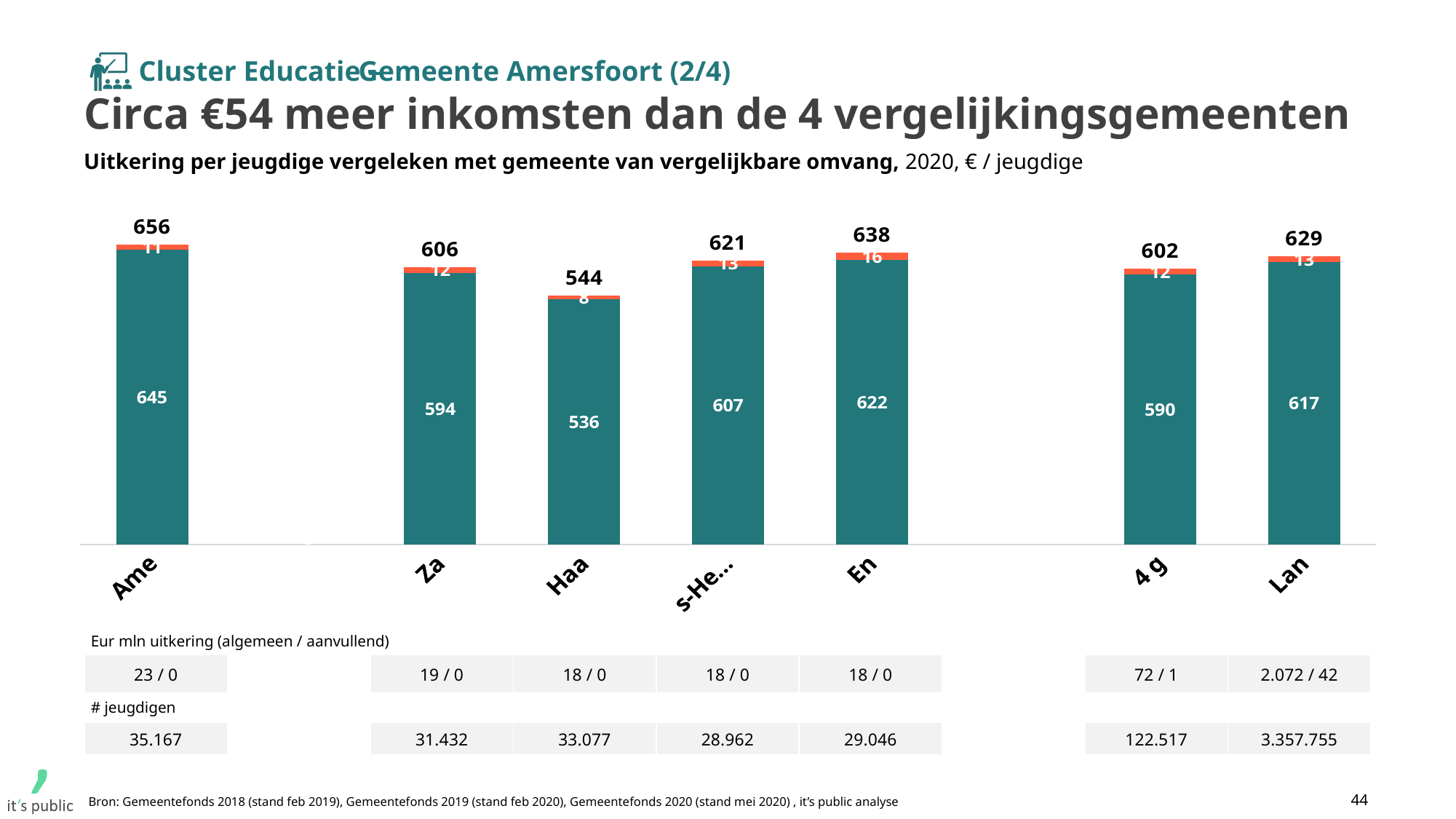
What is the difference between the total values for Ame and Haa? 112 What is the difference between the total values for Ame and 4 g? 54 What is the total value shown above the bar for Ame? 656 How many categories (bars) are shown in the chart? 7 What is the value of the large teal segment of the bar for En? 622 What is the value of the large teal segment of the bar for 4 g? 590 What kind of chart is shown on the slide? Stacked bar chart Which category has the highest total value? Ame Which category has the lowest total value? Haa What is the title of the chart (in bold above the bars)? Uitkering per jeugdige vergeleken met gemeente van vergelijkbare omvang What is the total value shown above the bar for Lan? 629 Which has a larger total value, En or Lan? En